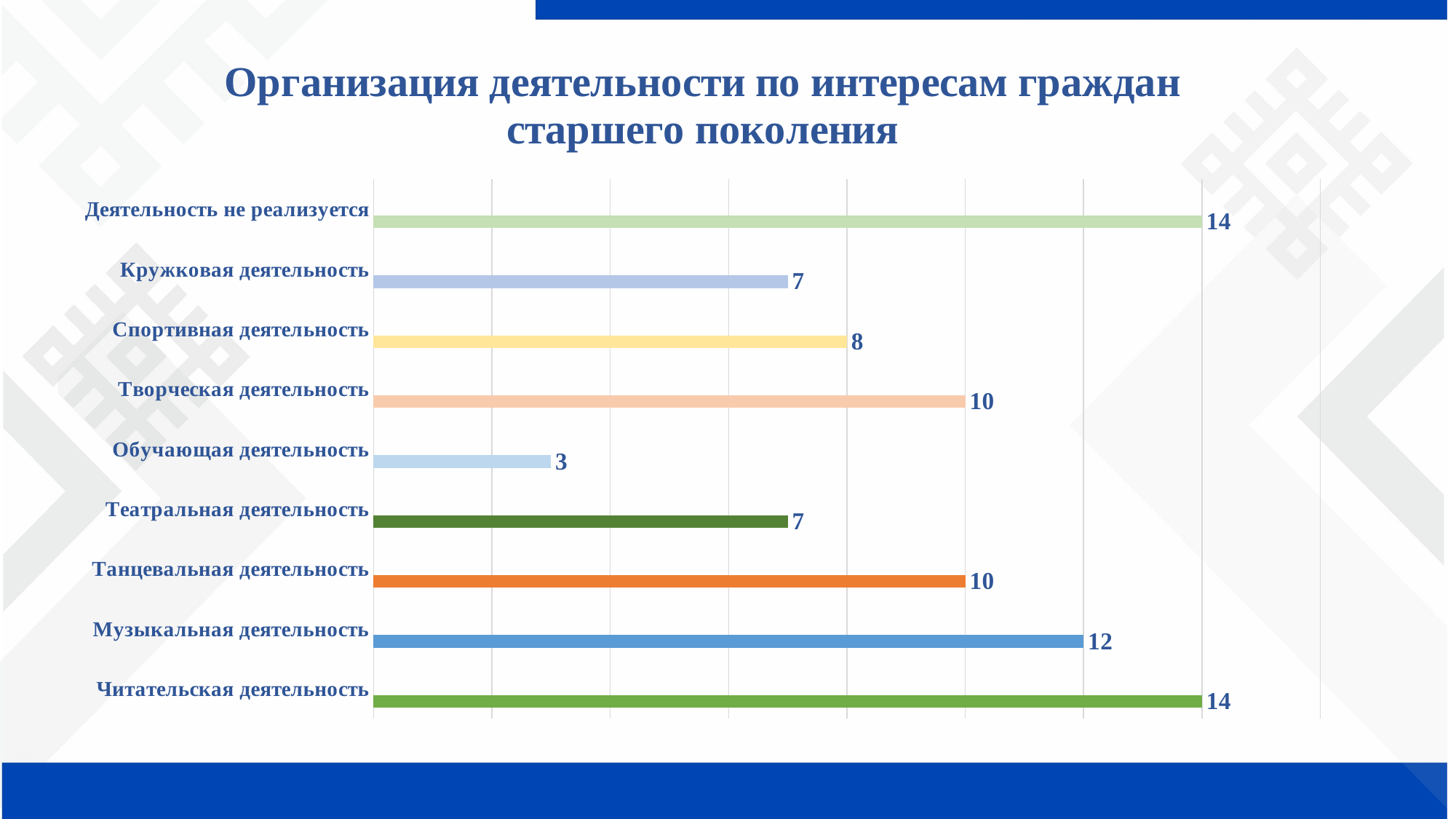
What is the difference between the values for Читательская деятельность and Музыкальная деятельность? 2 What kind of chart is shown on the slide? Bar chart What is the title of the chart on the slide? Организация деятельности по интересам граждан старшего поколения What is the difference between the values for Творческая деятельность and Обучающая деятельность? 7 Which category has the lowest value? Обучающая деятельность What is the value for Спортивная деятельность? 8 How many categories are shown in the chart? 9 What is the value for Деятельность не реализуется? 14 What is the value for Обучающая деятельность? 3 Which is larger, the value for Спортивная деятельность or the value for Кружковая деятельность? Спортивная деятельность What is the value for Музыкальная деятельность? 12 Which is larger, the value for Танцевальная деятельность or the value for Театральная деятельность? Танцевальная деятельность